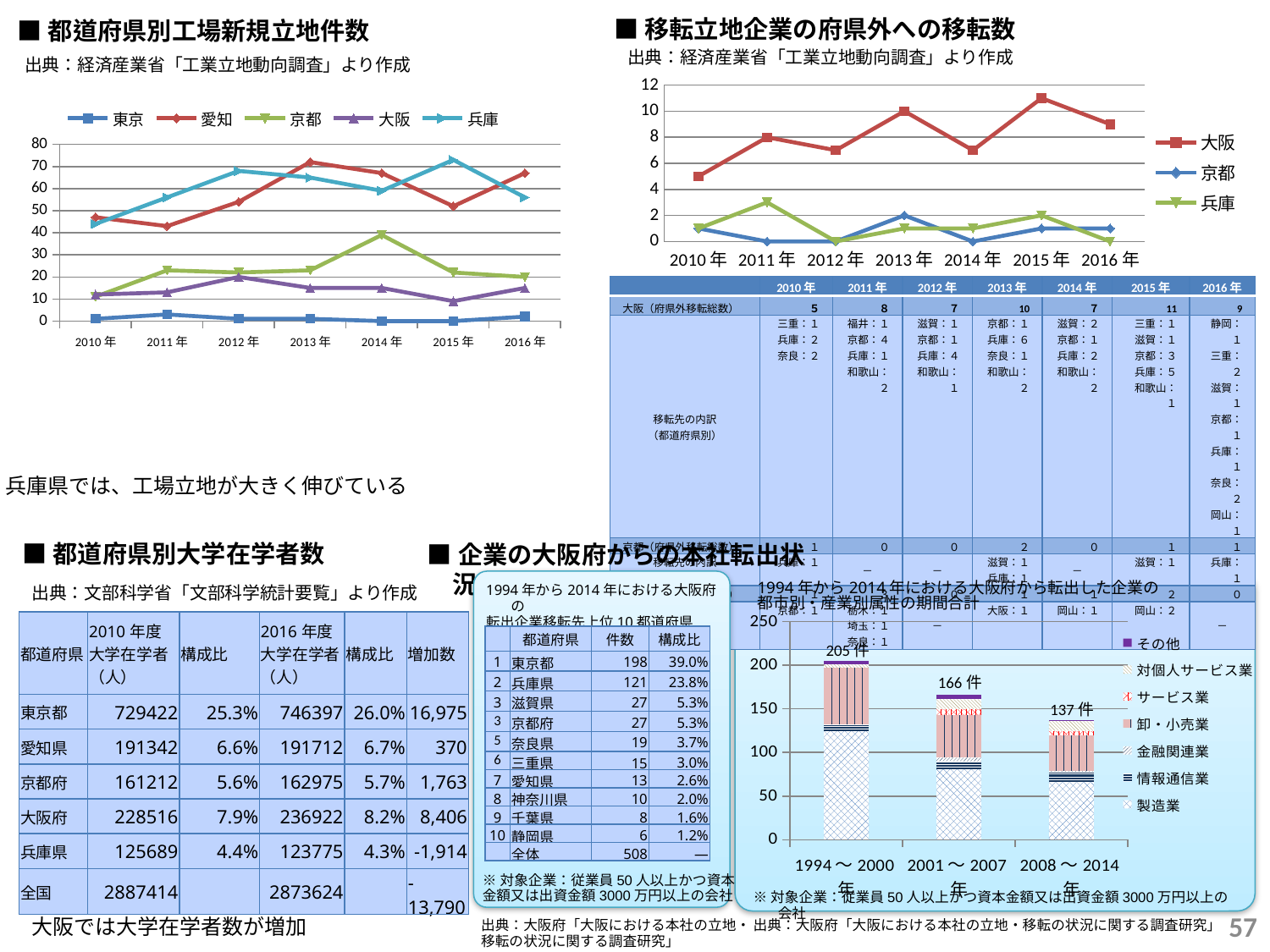
On the 都道府県別工場新規立地件数 chart (top left), what kind of chart is it? line chart On the 移転立地企業の府県外への移転数 chart (top right), in which year is the 大阪 value highest? 2015年 On the 都道府県別工場新規立地件数 chart (top left), how many series does the legend list? 5 On the 移転立地企業の府県外への移転数 chart (top right), how many series does the legend list? 3 On the 移転立地企業の府県外への移転数 chart (top right), what is the difference between the 大阪 values in 2015年 and 2010年? 6 On the 都道府県別工場新規立地件数 chart (top left), which series has the highest value in 2015年? 兵庫 On the 都道府県別工場新規立地件数 chart (top left), is the value for 兵庫 in 2015年 greater or less than 70? greater On the 移転立地企業の府県外への移転数 chart (top right), what is the value for 大阪 in 2015年? 11 On the stacked bar chart at the bottom right, what is the total for 1994〜2000年? 205件 On the stacked bar chart at the bottom right, do the bar totals rise or fall from 1994〜2000年 to 2008〜2014年? fall On the 都道府県別工場新規立地件数 chart (top left), which series has the lowest values across all years? 東京 On the 都道府県別工場新規立地件数 chart (top left), in 2016年, which is larger: 愛知 or 兵庫? 愛知